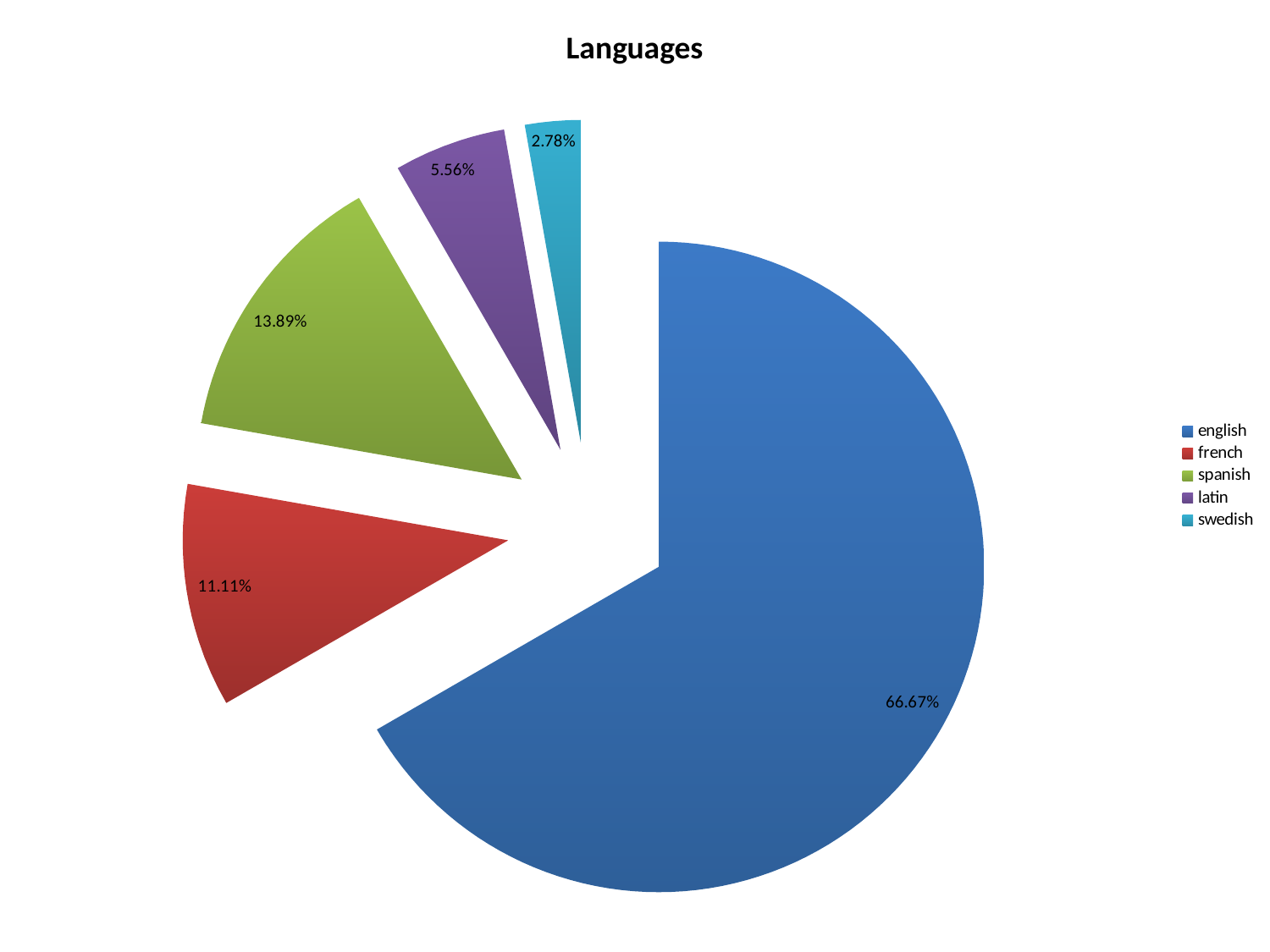
How many slices does the pie chart have? 5 Which has a larger share, spanish or french? spanish What type of chart is shown on the slide? pie chart What share of the pie does latin have? 5.56% What share of the pie does spanish have? 13.89% What share of the pie does french have? 11.11% What is the title of the chart? Languages Which language has the largest slice of the pie? english Which language has the smallest slice of the pie? swedish What is the difference in percentage points between the spanish and latin shares? 8.33